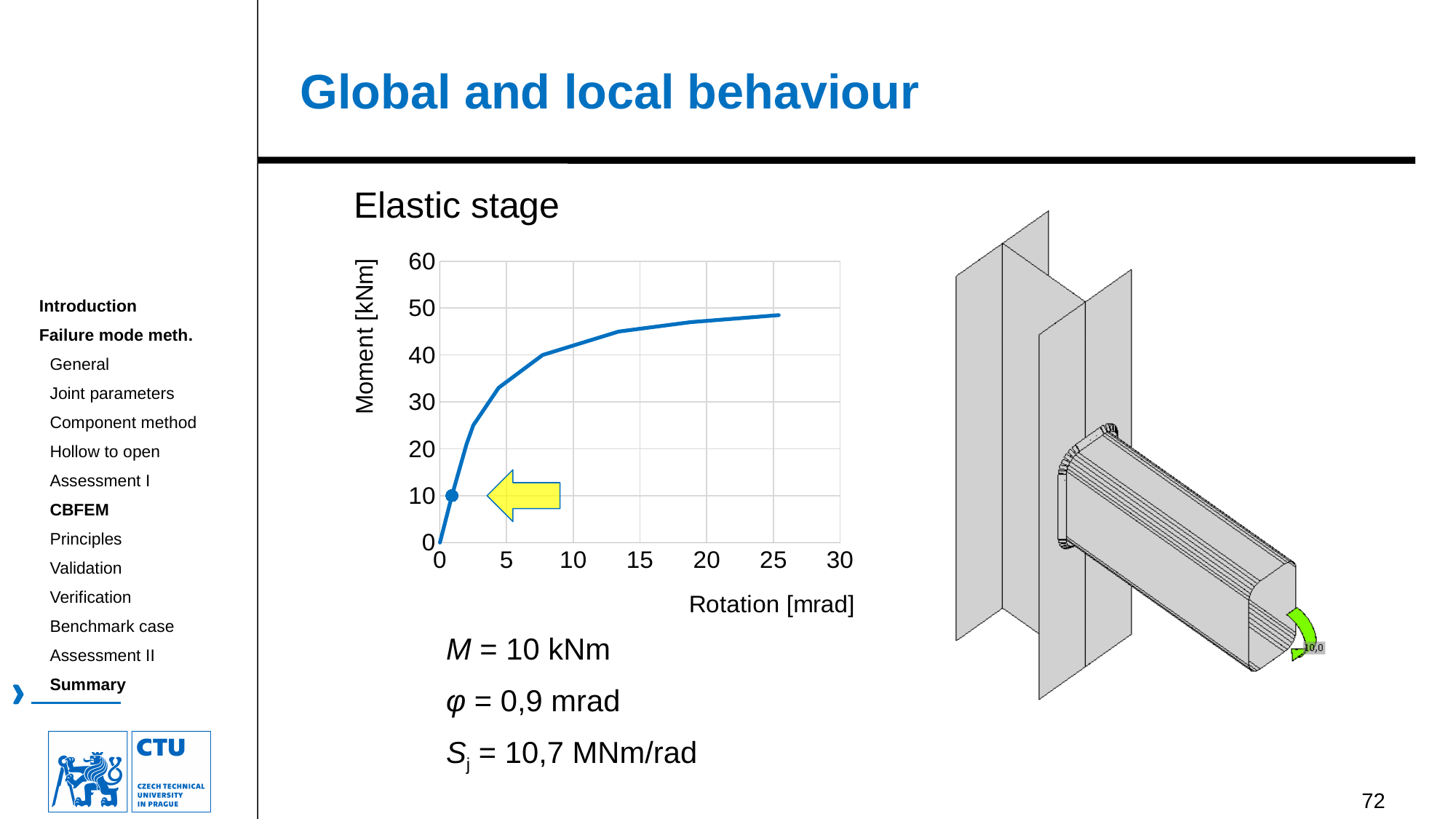
Is the moment at a rotation of 5 mrad greater or less than 30? greater Is the highest moment reached by the curve greater or less than 50? less What is the highest tick value shown on the y axis? 60 Is the moment at a rotation of 25 mrad greater or less than 40? greater How many data series are plotted in the chart? 1 What is the label of the y axis of the chart? Moment [kNm] What is the rotation at the highlighted point marked by the yellow arrow? 0,9 mrad What is the label of the x axis of the chart? Rotation [mrad] What is the moment at the highlighted point marked by the yellow arrow? 10 kNm What kind of chart is shown on the slide? line chart Does the moment rise or fall as rotation increases along the x axis? rises